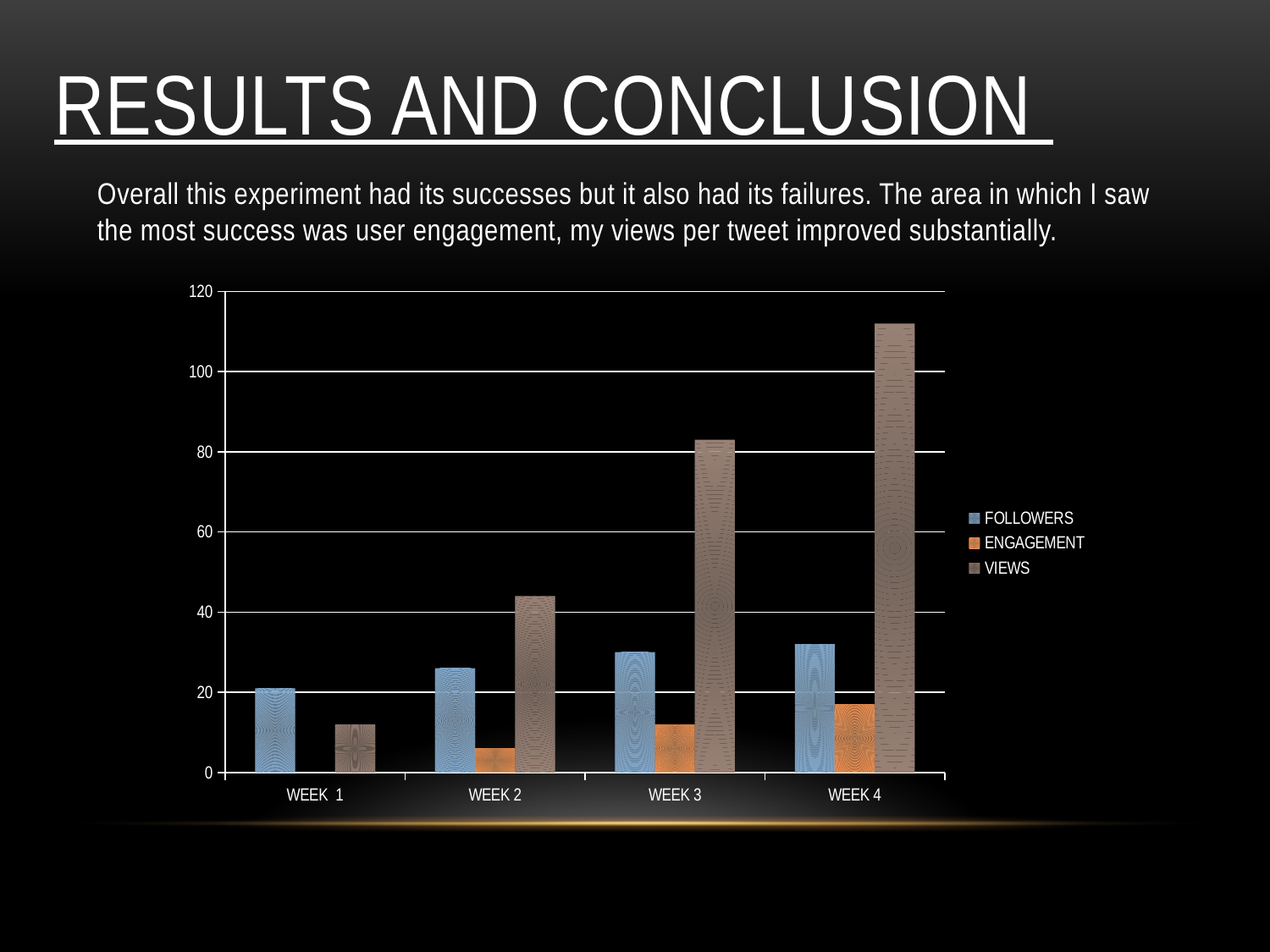
Is the VIEWS value for WEEK 4 greater or less than 100? greater Which series is shown in orange in the chart legend? ENGAGEMENT Which week has the highest VIEWS value? WEEK 4 Do the VIEWS values rise or fall from WEEK 1 to WEEK 4? rise How many series does the chart legend list? 3 In WEEK 3, which is larger: the VIEWS value or the FOLLOWERS value? VIEWS Is the VIEWS value for WEEK 2 greater or less than 60? less What kind of chart is shown on the slide? bar chart Which week has the lowest VIEWS value? WEEK 1 Is the VIEWS value for WEEK 3 greater or less than 60? greater How many week categories are shown on the x axis of the chart? 4